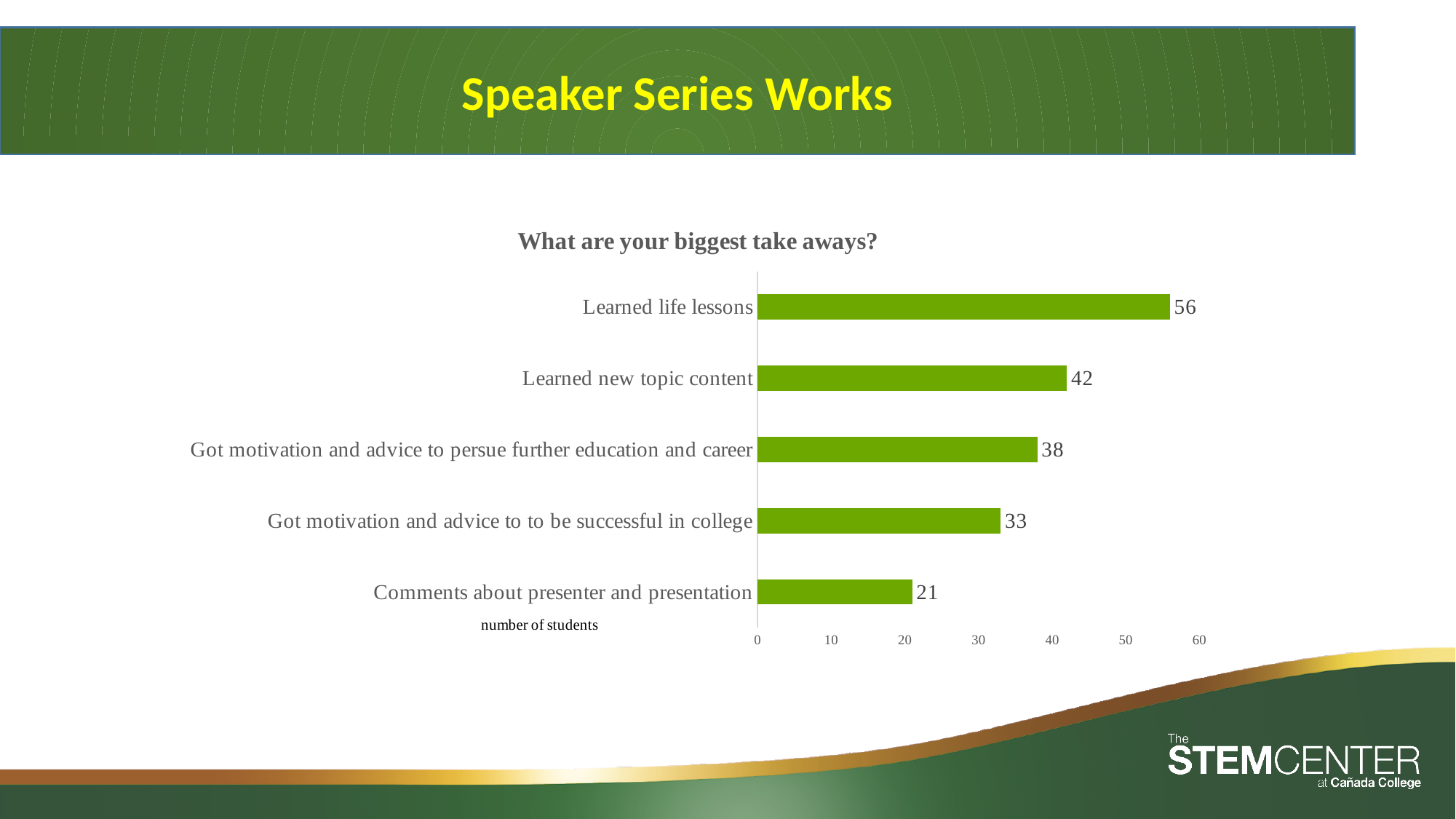
What is the value for "Comments about presenter and presentation"? 21 Which is larger: the value for "Got motivation and advice to persue further education and career" or the value for "Got motivation and advice to to be successful in college"? Got motivation and advice to persue further education and career What is the title of the chart? What are your biggest take aways? What is the value for "Learned life lessons"? 56 What is the difference between the values for "Learned life lessons" and "Learned new topic content"? 14 Which category has the highest value? Learned life lessons Which category has the lowest value? Comments about presenter and presentation What is the value for "Got motivation and advice to to be successful in college"? 33 How many categories are shown in the chart? 5 Is the value for "Learned new topic content" greater or less than 40? greater What kind of chart is shown on the slide? bar chart What is the value for "Learned new topic content"? 42